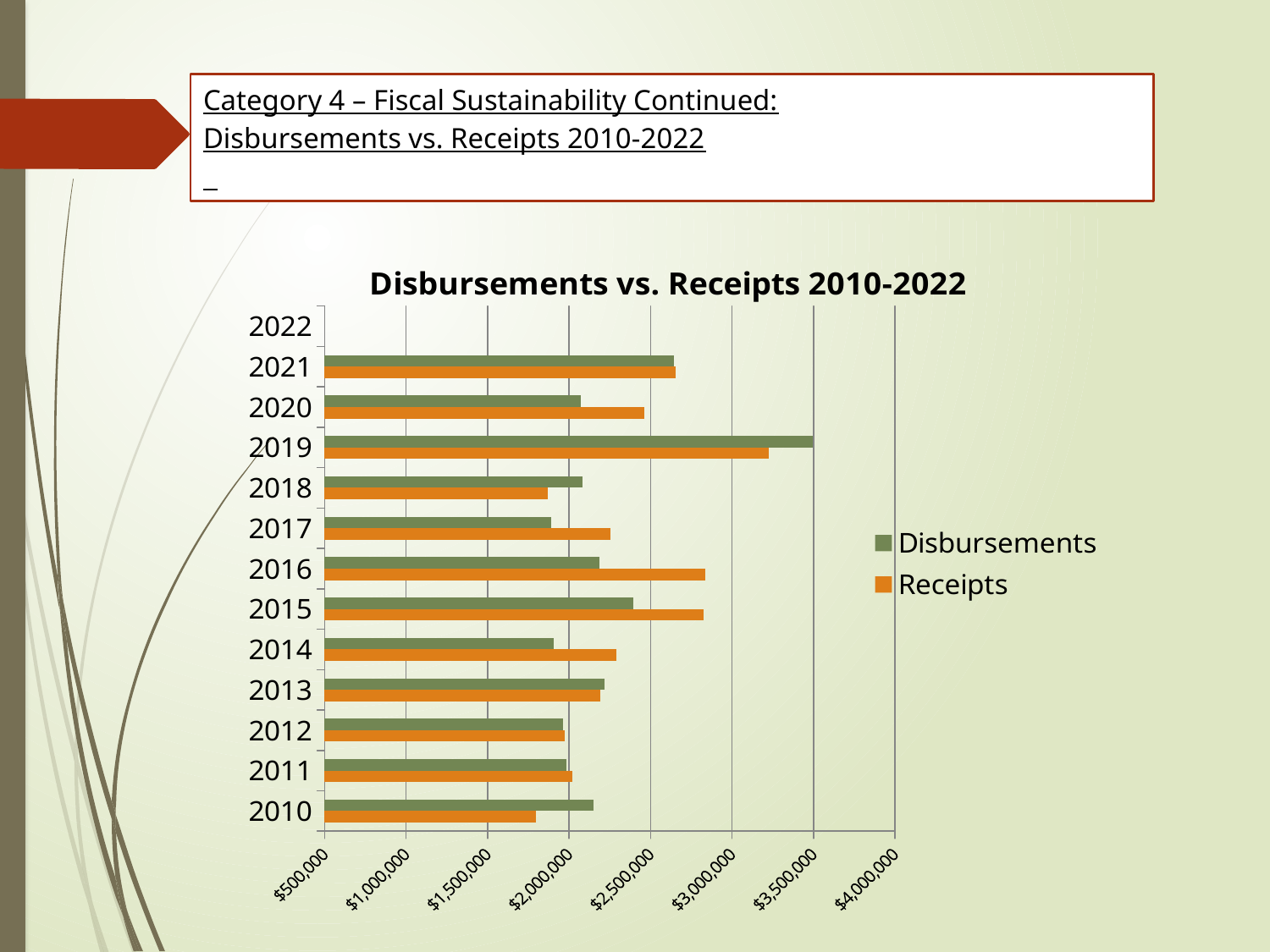
In 2016, which is larger, Disbursements or Receipts? Receipts How many years are listed on the vertical axis of the chart? 13 What type of chart is shown on the slide? Bar chart Is the Disbursements value for 2019 greater or less than $3,000,000? greater Is the Receipts value for 2016 greater or less than $2,500,000? greater What is the title of the chart? Disbursements vs. Receipts 2010-2022 Which year has the highest Disbursements value? 2019 How many series does the legend list? 2 Is the Receipts value for 2010 greater or less than $2,000,000? less Which year has the highest Receipts value? 2019 In 2010, which is larger, Disbursements or Receipts? Disbursements